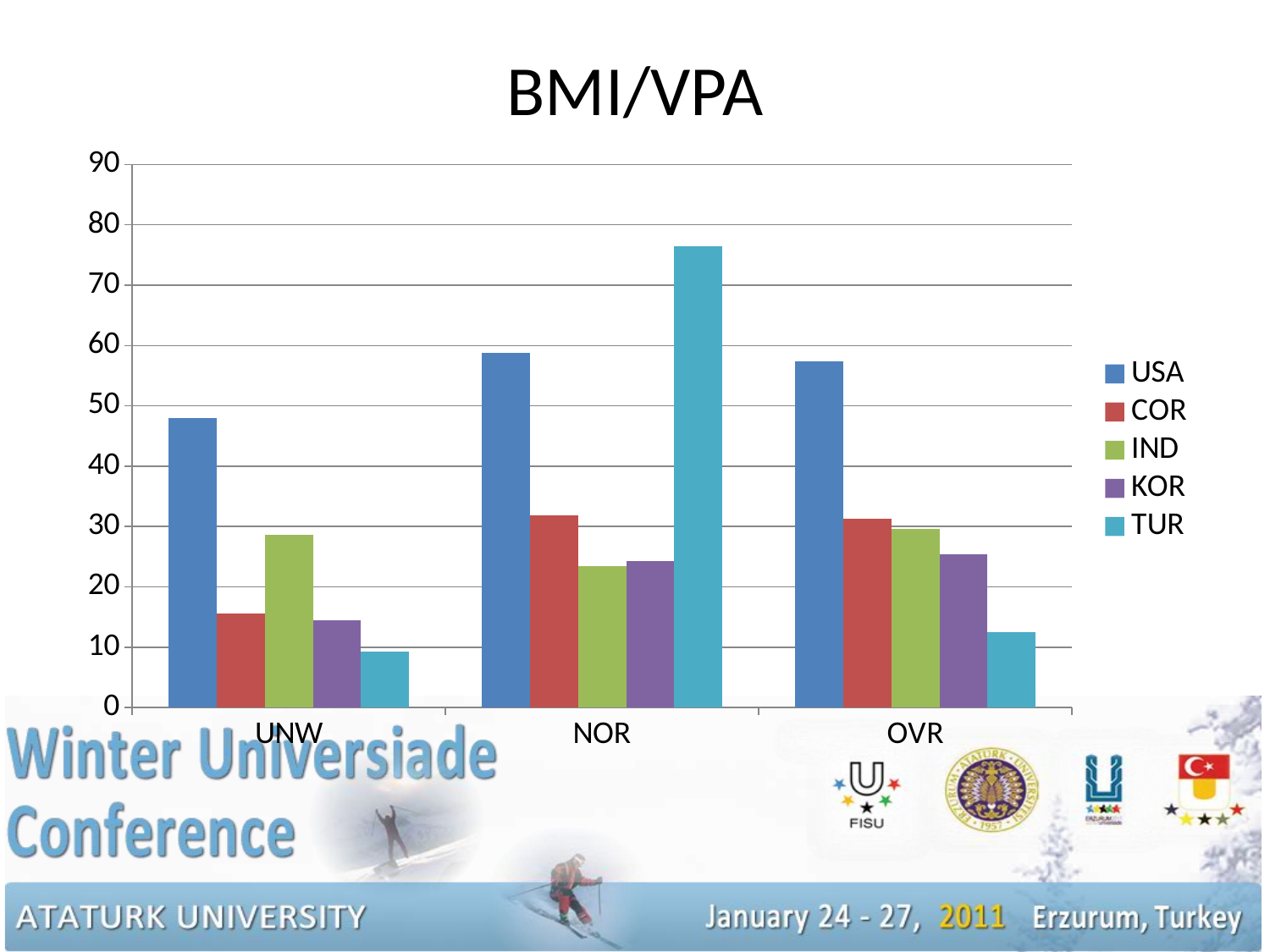
What is the title of the chart? BMI/VPA What type of chart is shown on the slide? bar chart Is the value for TUR in the NOR category greater or less than 70? greater Which series has the highest value in the NOR category? TUR Which is larger, the value for USA in NOR or the value for USA in UNW? USA in NOR How many series does the legend list? 5 Which series has the highest value in the OVR category? USA Is the value for TUR in the OVR category greater or less than 20? less Is the value for USA in the UNW category greater or less than 50? less How many categories are shown on the x axis? 3 Which series has the lowest value in the UNW category? TUR Which is larger, the value for IND in UNW or the value for COR in UNW? IND in UNW